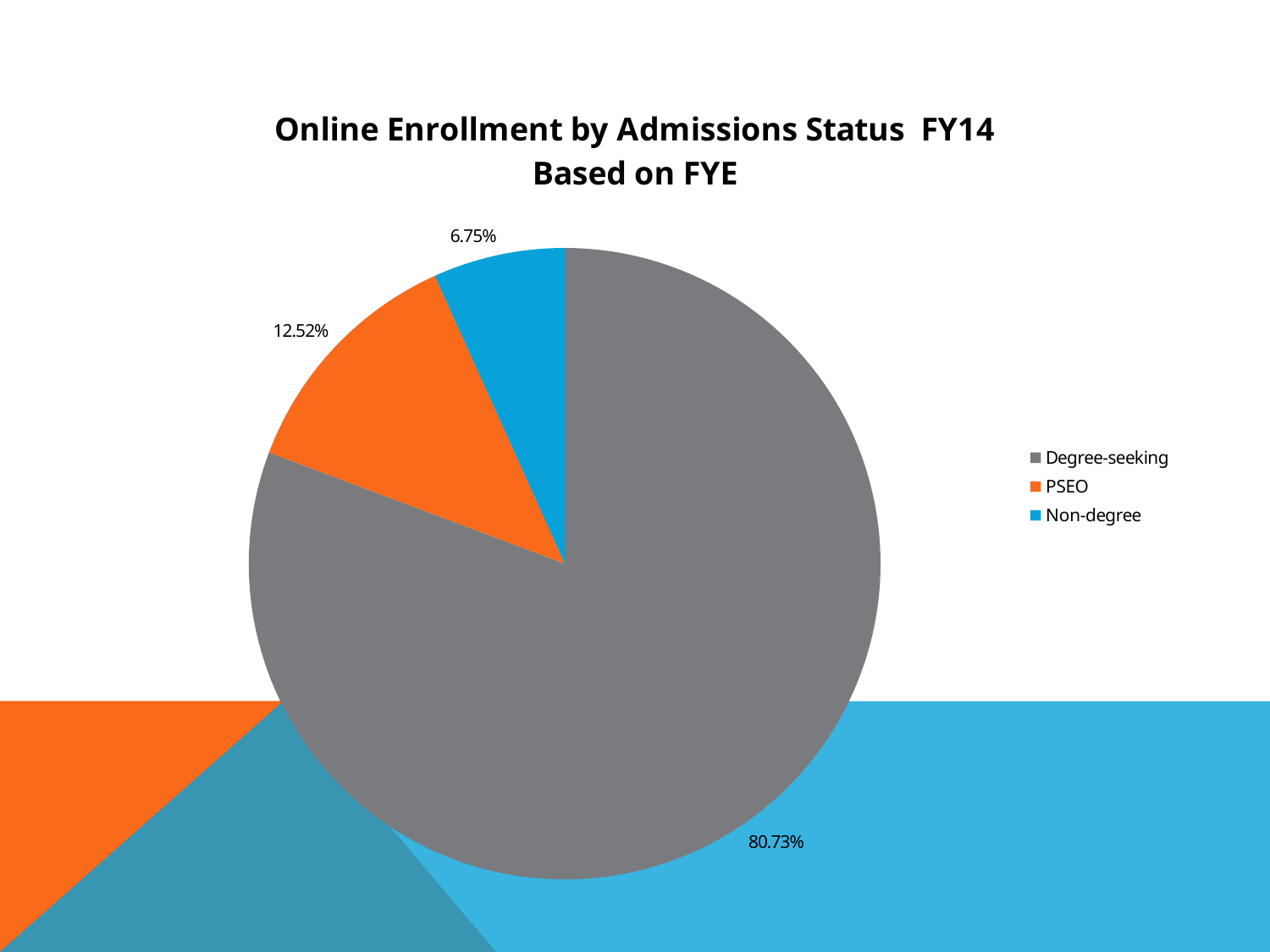
What share of online enrollment is Non-degree? 6.75% What is the difference between the Degree-seeking share and the PSEO share? 68.21% What share of online enrollment is Degree-seeking? 80.73% How many categories does the legend list? 3 What share of online enrollment is PSEO? 12.52% What is the title of the chart? Online Enrollment by Admissions Status FY14 Based on FYE What colour represents PSEO in the chart? orange Which is larger, the PSEO share or the Non-degree share? PSEO Which admissions status has the largest share of online enrollment? Degree-seeking What type of chart is shown on the slide? pie chart Which admissions status has the smallest share of online enrollment? Non-degree What is the difference between the PSEO share and the Non-degree share? 5.77%